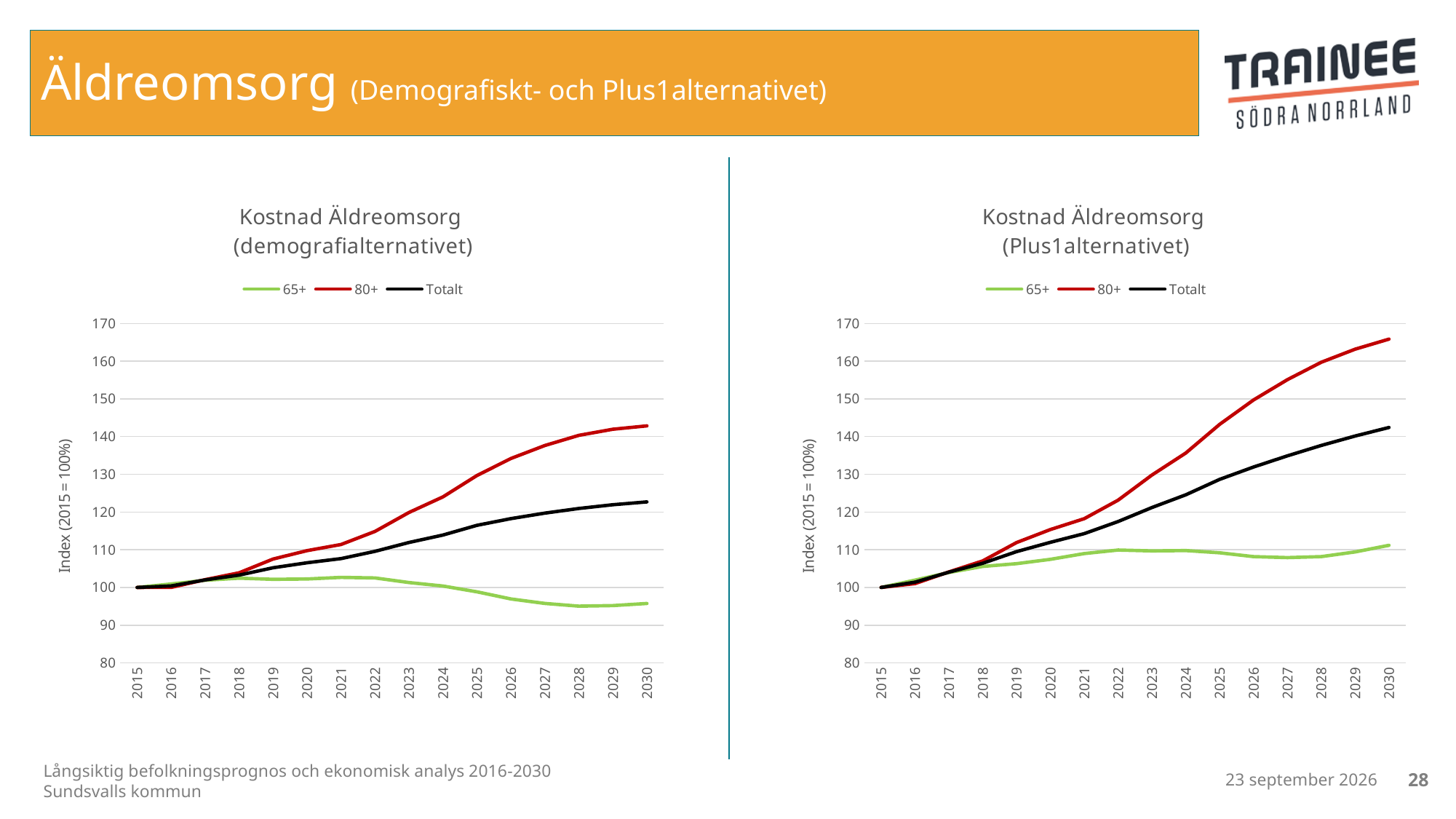
How many years are shown on the x axis of the left chart, 'Kostnad Äldreomsorg (demografialternativet)'? 16 Is the 80+ value in 2030 higher in the right chart (Plus1alternativet) or in the left chart (demografialternativet)? Right chart (Plus1alternativet) What is the y-axis label of the right chart, 'Kostnad Äldreomsorg (Plus1alternativet)'? Index (2015 = 100%) In the right chart, 'Kostnad Äldreomsorg (Plus1alternativet)', does the 80+ series rise or fall from 2015 to 2030? rise In the left chart, 'Kostnad Äldreomsorg (demografialternativet)', is the value for 80+ in 2030 greater or less than 140? greater In the left chart, 'Kostnad Äldreomsorg (demografialternativet)', which series has the highest value in 2030? 80+ In the right chart, 'Kostnad Äldreomsorg (Plus1alternativet)', is the value for Totalt in 2030 greater or less than 130? greater In the left chart, 'Kostnad Äldreomsorg (demografialternativet)', which series has the lowest value in 2030? 65+ In the left chart, 'Kostnad Äldreomsorg (demografialternativet)', is the value for 65+ in 2030 greater or less than 100? less In the left chart, 'Kostnad Äldreomsorg (demografialternativet)', what is the index value of the Totalt series in 2015? 100 How many series does the legend of the right chart, 'Kostnad Äldreomsorg (Plus1alternativet)', list? 3 What kind of chart is the left chart, 'Kostnad Äldreomsorg (demografialternativet)'? Line chart